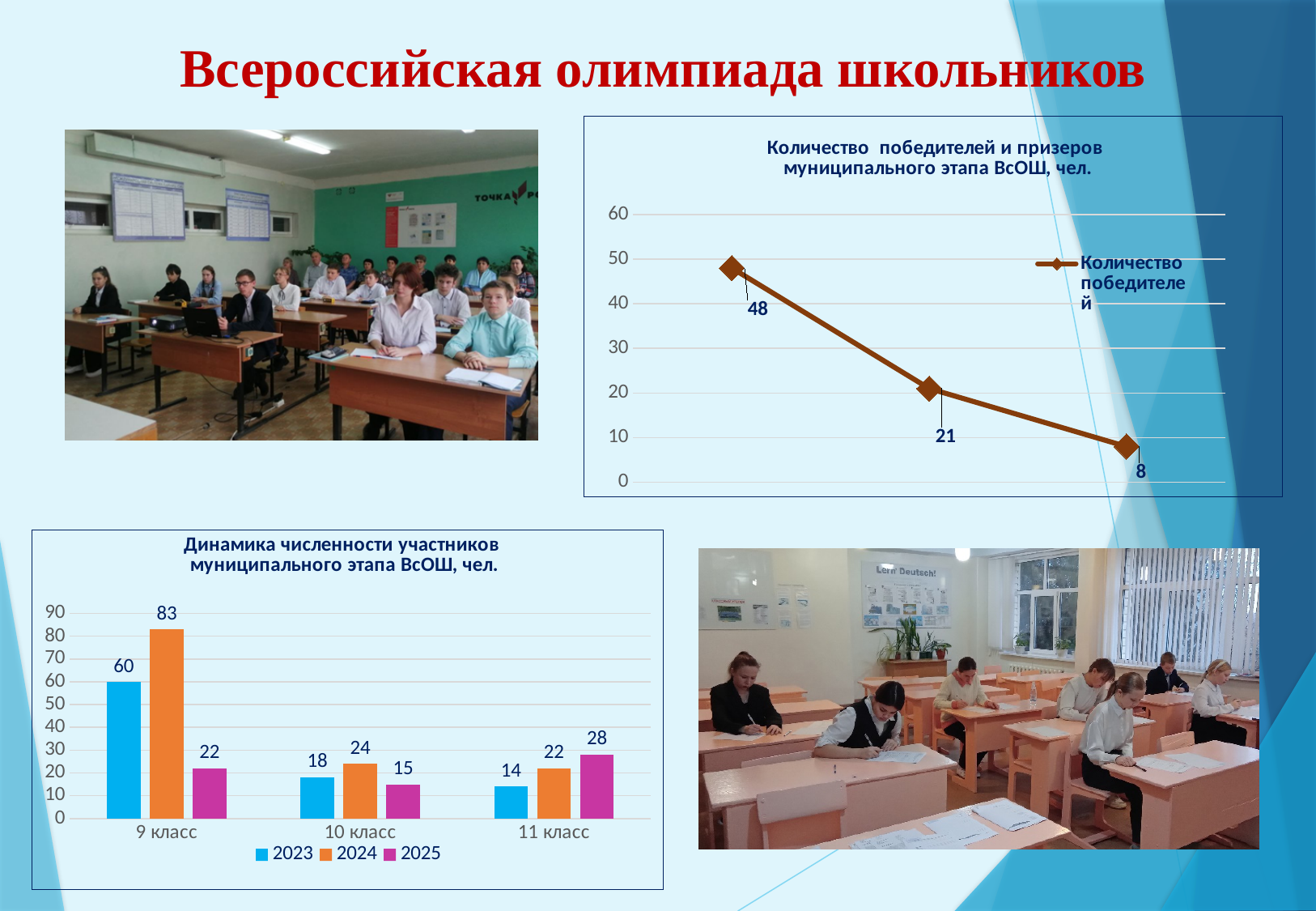
In the chart 'Динамика численности участников муниципального этапа ВсОШ, чел.', what is the value for 11 класс in 2025? 28 In the chart 'Динамика численности участников муниципального этапа ВсОШ, чел.', which is larger for 11 класс: the 2023 value or the 2025 value? 2025 In the chart 'Динамика численности участников муниципального этапа ВсОШ, чел.', what is the value for 10 класс in 2023? 18 How many series does the legend of the chart 'Динамика численности участников муниципального этапа ВсОШ, чел.' list? 3 In the chart 'Динамика численности участников муниципального этапа ВсОШ, чел.', what is the difference between the 2024 and 2023 values for 9 класс? 23 What kind of chart is 'Динамика численности участников муниципального этапа ВсОШ, чел.'? Bar chart In the chart 'Динамика численности участников муниципального этапа ВсОШ, чел.', what is the value for 9 класс in 2024? 83 In the chart 'Динамика численности участников муниципального этапа ВсОШ, чел.', which class has the highest value for 2023? 9 класс In the chart 'Количество победителей и призеров муниципального этапа ВсОШ, чел.', do the values rise or fall from left to right? Fall In the chart 'Динамика численности участников муниципального этапа ВсОШ, чел.', which class has the lowest value for 2025? 10 класс In the chart 'Количество победителей и призеров муниципального этапа ВсОШ, чел.', what is the difference between the first and last data points? 40 In the chart 'Количество победителей и призеров муниципального этапа ВсОШ, чел.', what is the value of the first data point? 48